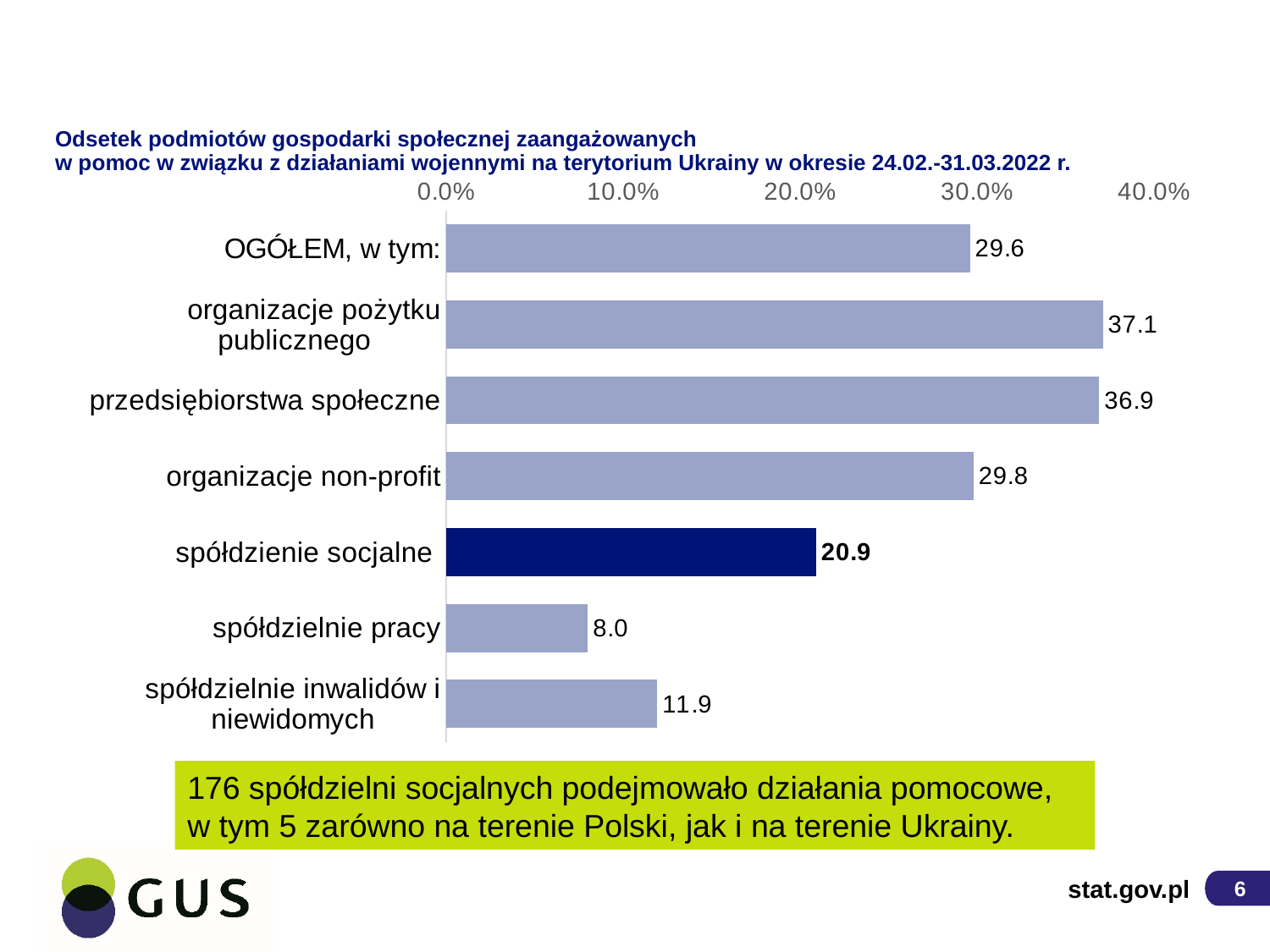
What kind of chart is shown on the slide? bar chart How many categories are shown in the chart? 7 What is the value for "spółdzielnie inwalidów i niewidomych"? 11.9 What is the difference between the values for "spółdzielnie inwalidów i niewidomych" and "spółdzielnie pracy"? 3.9 What is the value for "organizacje non-profit"? 29.8 What is the difference between the values for "organizacje pożytku publicznego" and "przedsiębiorstwa społeczne"? 0.2 Which category has the lowest value? spółdzielnie pracy Which is larger, the value for "organizacje non-profit" or the value for "OGÓŁEM, w tym:"? organizacje non-profit Which category has the highest value? organizacje pożytku publicznego Is the value for "spółdzienie socjalne" greater or less than 30.0%? less What is the value for "spółdzienie socjalne"? 20.9 What is the value for "OGÓŁEM, w tym:"? 29.6